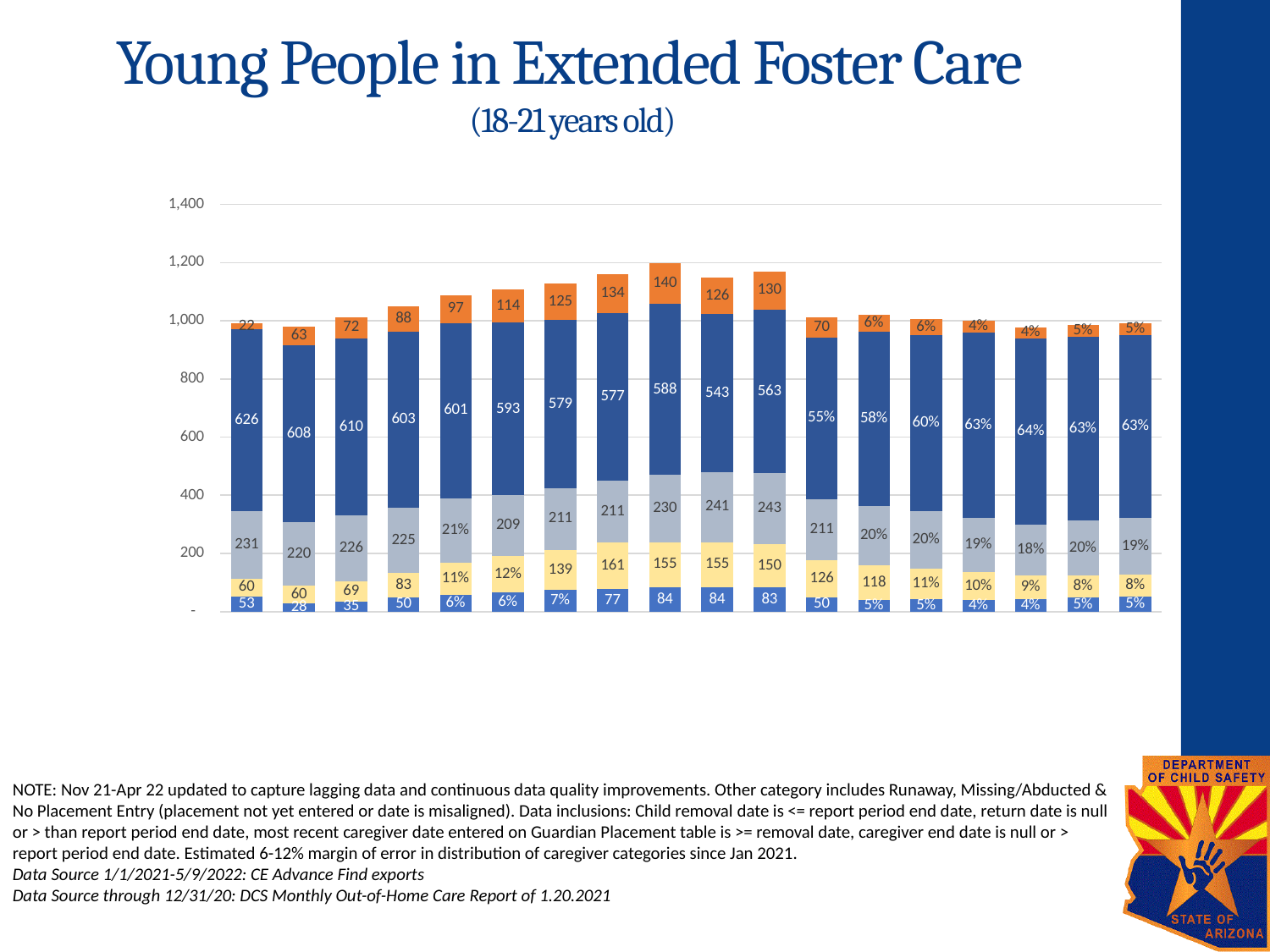
How many stacked bars are plotted in the chart? 18 What is the largest value labelled on any yellow segment in the chart? 161 What is the value of the dark blue segment in the first (leftmost) bar of the chart? 626 What is the highest value shown on the vertical axis of the chart? 1,400 Is the tallest bar in the chart greater or less than 1,000? greater What is the total of the first (leftmost) stacked bar, summing its labelled segments 53, 60, 231, 626 and 22? 992 Which is larger: the dark blue segment labelled 588 or the dark blue segment labelled 543? 588 What kind of chart is shown on the slide? Stacked bar chart What is the largest value labelled on any dark blue segment in the chart? 626 What is the largest value labelled on any orange (top) segment in the chart? 140 What is the difference between the largest orange segment value (140) and the smallest labelled orange segment value (22)? 118